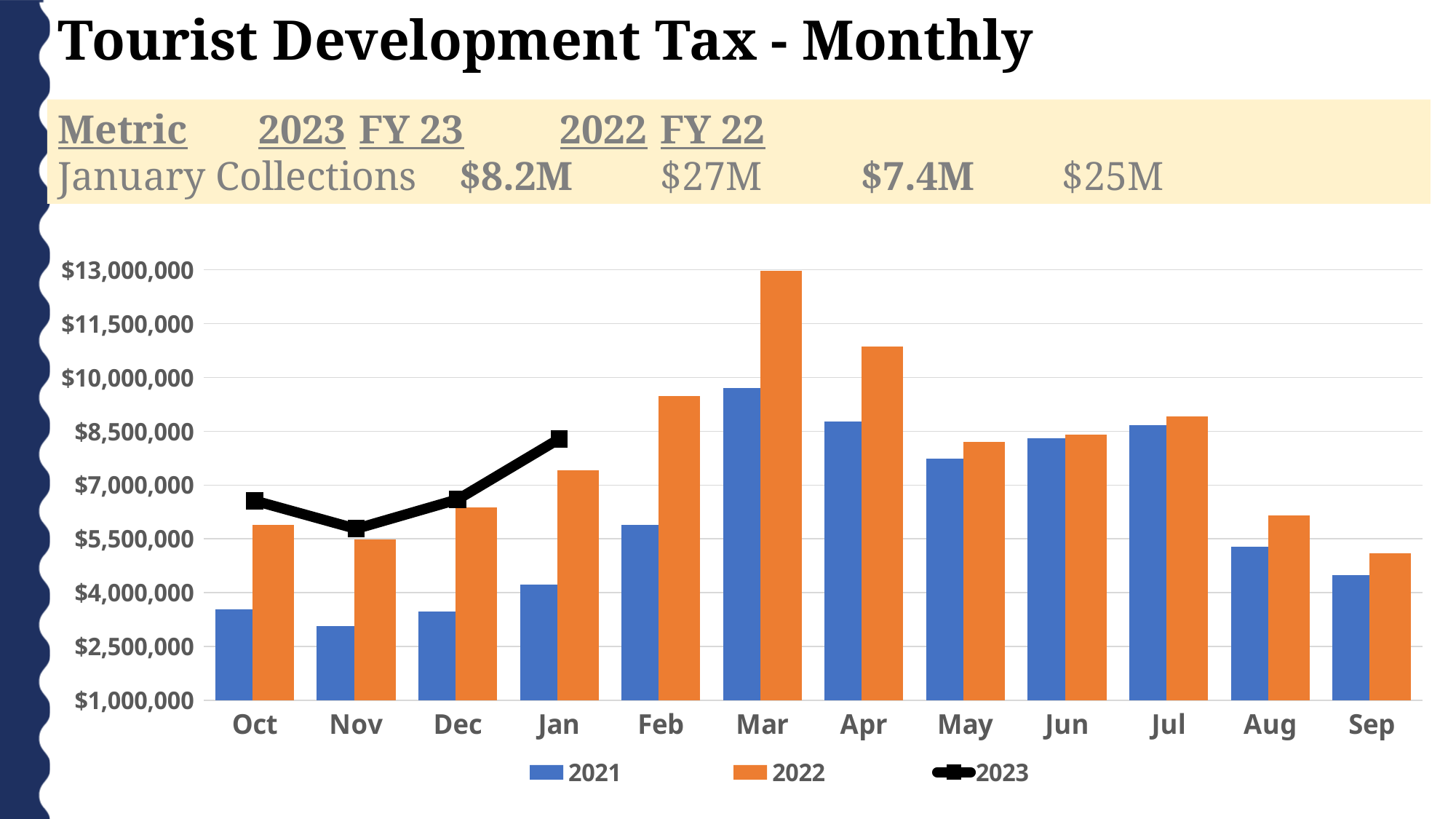
Is the 2022 value for Apr greater or less than $10,000,000? greater Which colour represents the 2022 series in the chart? orange In which month is the 2021 value lowest? Nov Does the 2023 line rise or fall from Nov to Jan? rise Is the 2022 value for Mar greater or less than $11,500,000? greater What kind of chart is shown on the slide? bar chart with a line In which month is the 2021 value highest? Mar How many months are shown along the x axis of the chart? 12 Is the 2021 value for Oct greater or less than $4,000,000? less For Jan, which series has the larger value, 2021 or 2022? 2022 How many series does the chart legend list? 3 In which month is the 2022 value highest? Mar